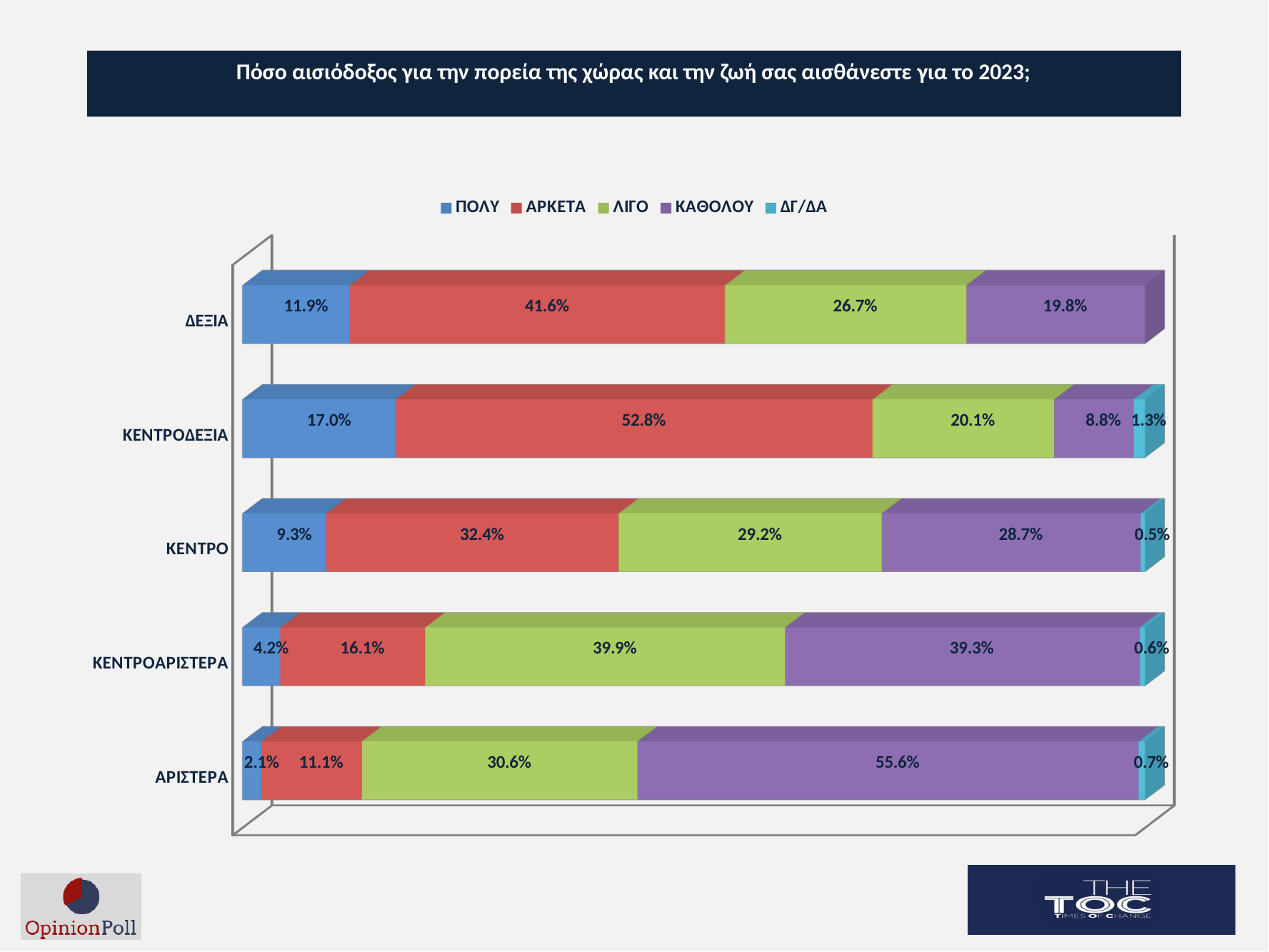
What is the ΔΓ/ΔΑ value for ΚΕΝΤΡΟ? 0.5% What is the ΑΡΚΕΤΑ value for ΚΕΝΤΡΟΔΕΞΙΑ? 52.8% For ΔΕΞΙΑ, which is larger: the ΑΡΚΕΤΑ value or the ΛΙΓΟ value? ΑΡΚΕΤΑ How many series does the legend list? 5 Which category has the highest ΛΙΓΟ value? ΚΕΝΤΡΟΑΡΙΣΤΕΡΑ What kind of chart is shown on the slide? Stacked bar chart What is the difference between the ΑΡΚΕΤΑ values for ΚΕΝΤΡΟΔΕΞΙΑ and ΔΕΞΙΑ? 11.2 percentage points How many categories (political groups) are plotted on the chart? 5 What is the ΚΑΘΟΛΟΥ value for ΑΡΙΣΤΕΡΑ? 55.6% Which category has the lowest ΠΟΛΥ value? ΑΡΙΣΤΕΡΑ What is the total of the stacked bar for ΚΕΝΤΡΟΔΕΞΙΑ? 100.0% Which category has the highest ΠΟΛΥ value? ΚΕΝΤΡΟΔΕΞΙΑ